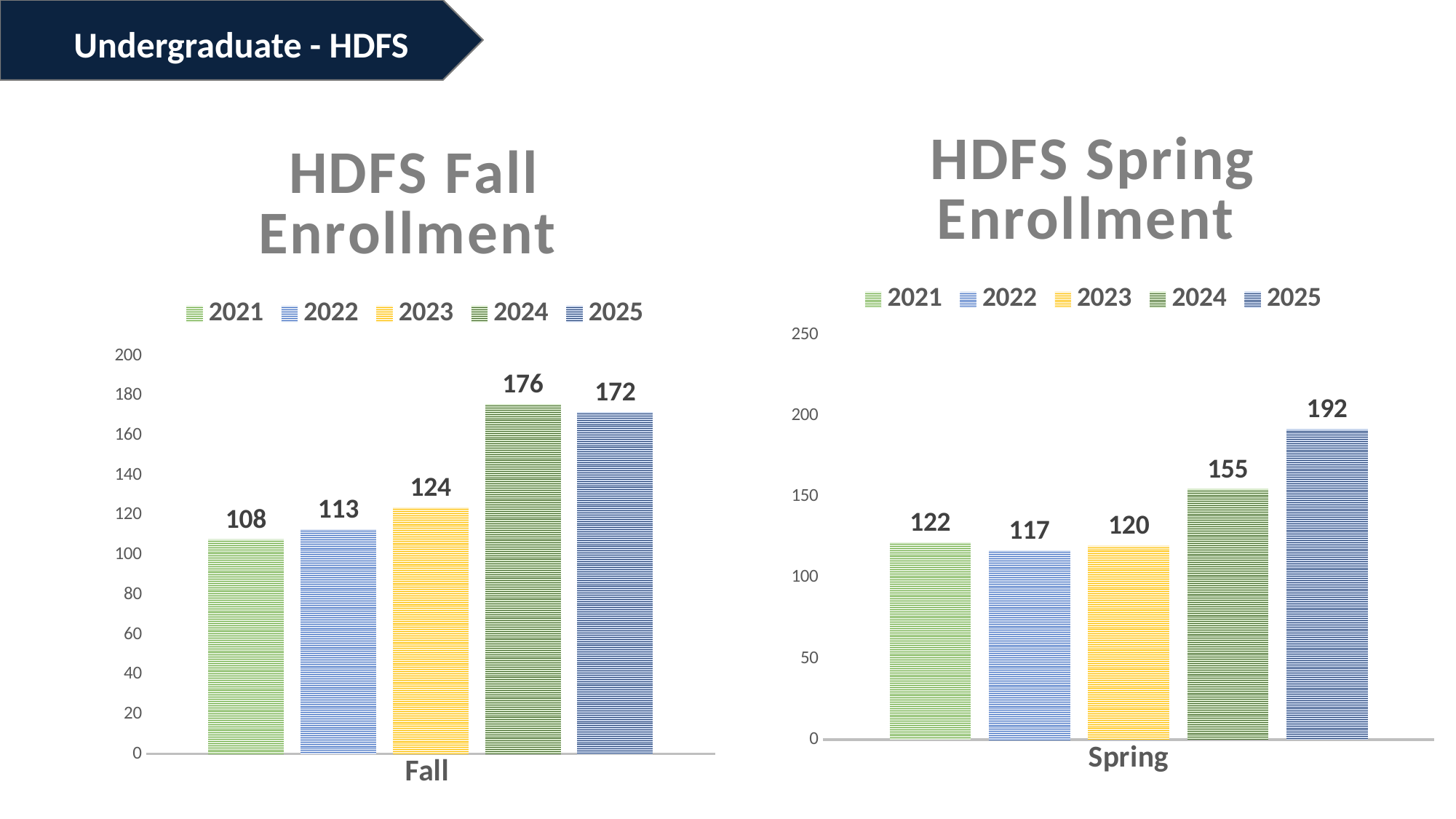
In the HDFS Fall Enrollment chart, which is larger, the value for 2024 or the value for 2025? 2024 In the HDFS Fall Enrollment chart, what is the label on the x axis under the bars? Fall In the HDFS Fall Enrollment chart, which year has the highest enrollment? 2024 In the HDFS Fall Enrollment chart, what is the value for 2023? 124 How many bars are plotted in the HDFS Fall Enrollment chart? 5 In the HDFS Spring Enrollment chart, is the value for 2025 greater or less than 150? greater In the HDFS Fall Enrollment chart, what is the difference between the 2024 and 2021 values? 68 How many series does the legend of the HDFS Spring Enrollment chart list? 5 In the HDFS Spring Enrollment chart, what is the value for 2024? 155 In the HDFS Spring Enrollment chart, which year has the lowest enrollment? 2022 What kind of chart is the HDFS Spring Enrollment chart? Bar chart In the HDFS Spring Enrollment chart, what is the difference between the 2025 and 2024 values? 37